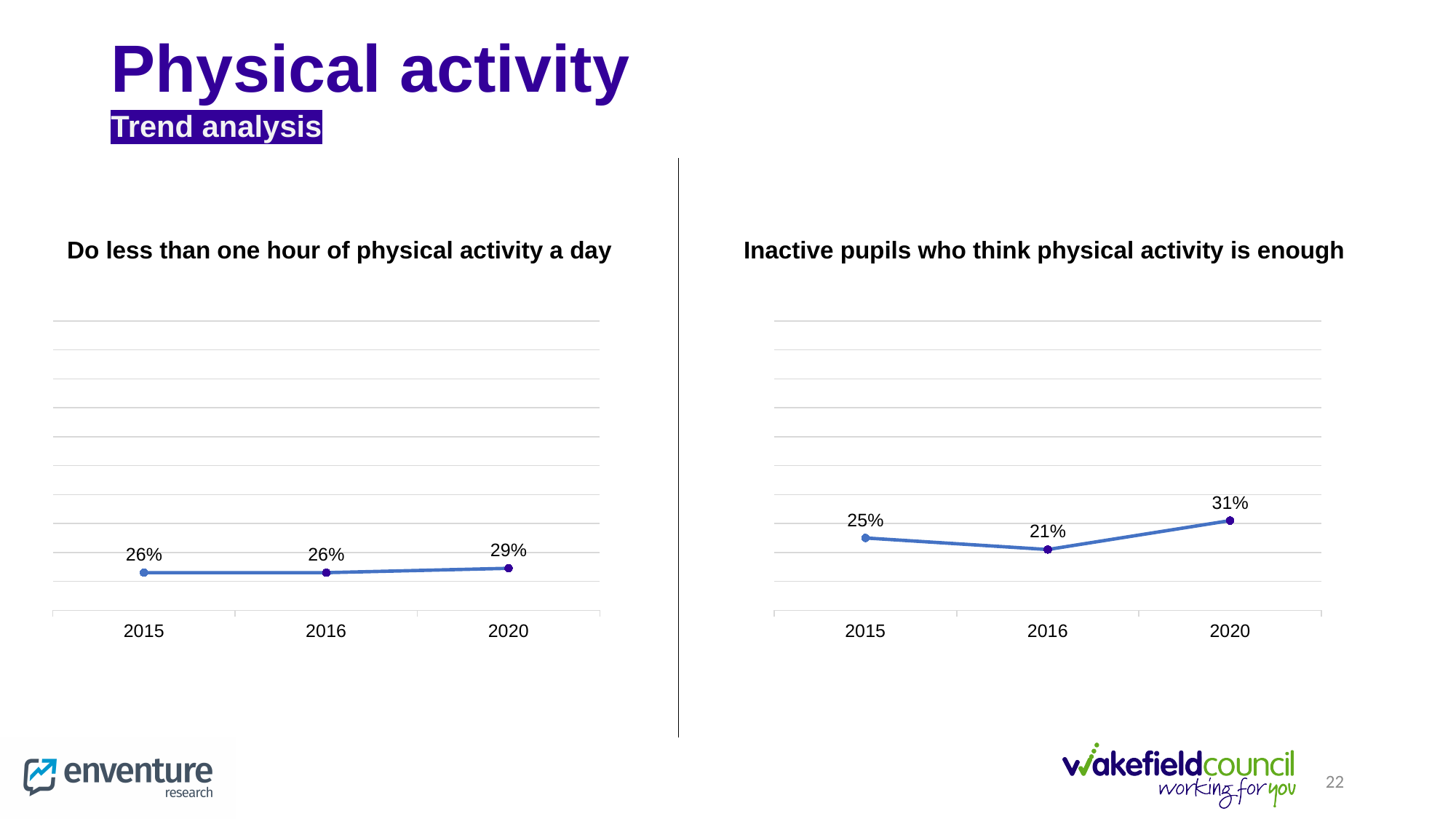
How many data points are plotted in the 'Do less than one hour of physical activity a day' chart? 3 In the 'Inactive pupils who think physical activity is enough' chart, what is the difference between the 2020 and 2016 values? 10 percentage points In the 'Inactive pupils who think physical activity is enough' chart, which year has the lowest value? 2016 What type of chart is the 'Inactive pupils who think physical activity is enough' chart? line chart In the 'Inactive pupils who think physical activity is enough' chart, what is the value for 2016? 21% In the 'Do less than one hour of physical activity a day' chart, what is the value for 2020? 29% In the 'Inactive pupils who think physical activity is enough' chart, is the value for 2015 larger or smaller than the value for 2016? larger In the 'Do less than one hour of physical activity a day' chart, what is the value for 2015? 26% In the 'Inactive pupils who think physical activity is enough' chart, what is the value for 2020? 31% In the 'Do less than one hour of physical activity a day' chart, which year has the highest value? 2020 In the 'Do less than one hour of physical activity a day' chart, what is the difference between the 2020 and 2015 values? 3 percentage points In the 'Inactive pupils who think physical activity is enough' chart, which year has the highest value? 2020